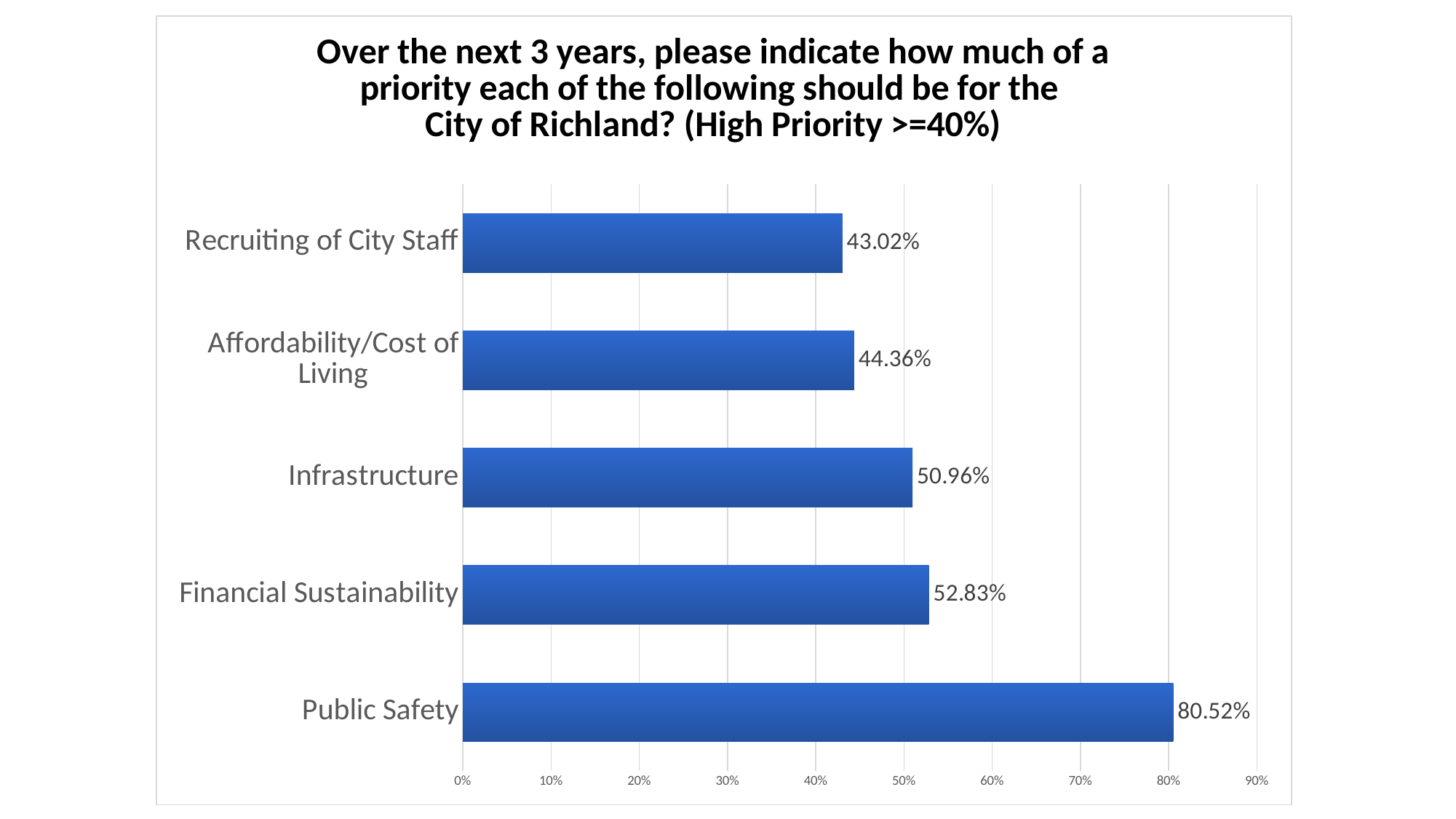
What is the value for Recruiting of City Staff? 43.02% What is the difference between the values for Public Safety and Financial Sustainability? 27.69% Which category has the lowest value? Recruiting of City Staff What threshold for High Priority is stated in the chart title? >=40% Which is larger, the value for Financial Sustainability or the value for Infrastructure? Financial Sustainability How many categories are shown in the chart? 5 What kind of chart is shown on the slide? bar chart Is the value for Public Safety greater or less than 70%? greater What is the value for Affordability/Cost of Living? 44.36% What is the value for Infrastructure? 50.96% What is the value for Public Safety? 80.52% Which category has the highest value? Public Safety